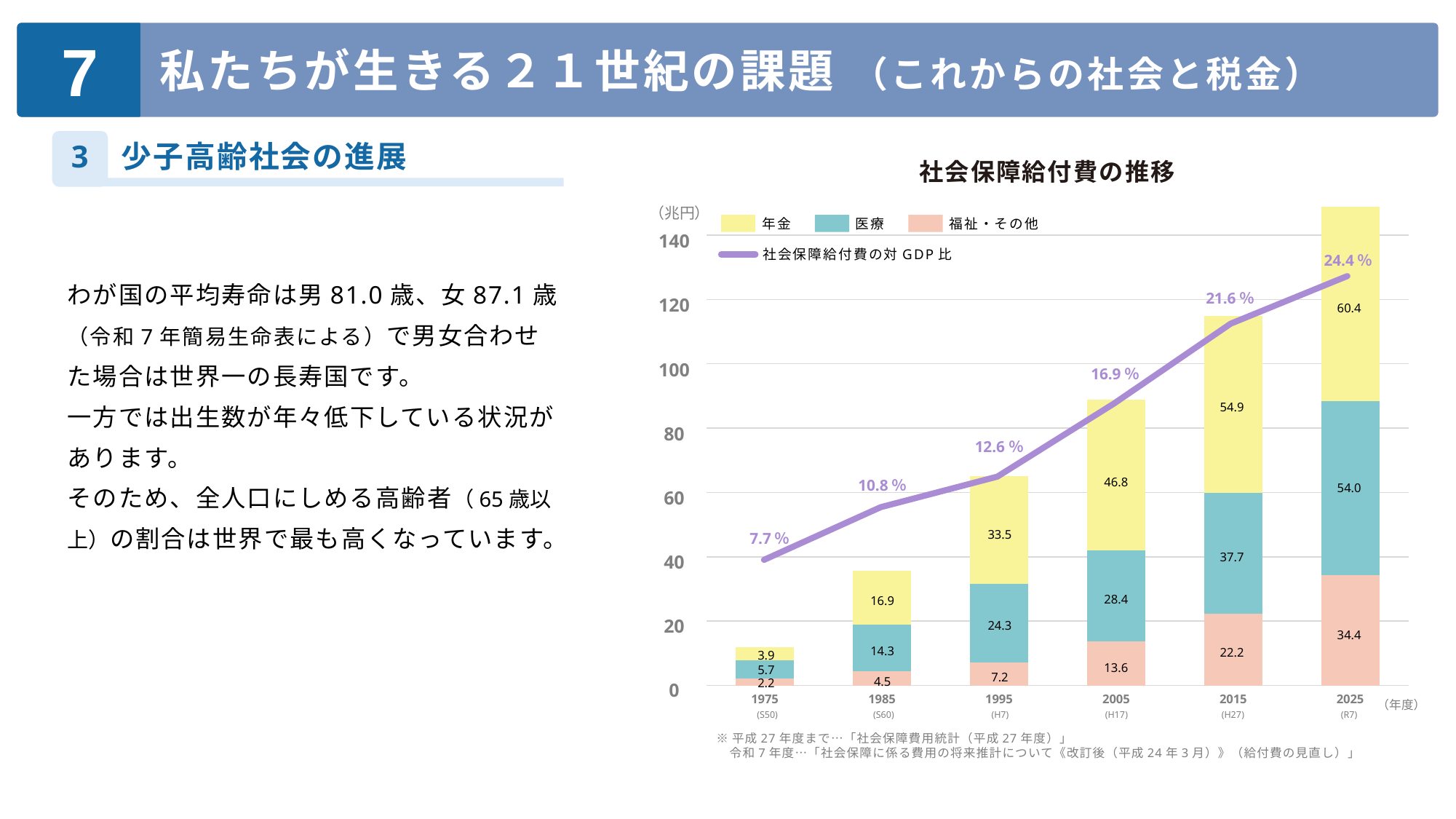
What is the total of the stacked bar for 2025? 148.8 What is the 医療 value for 1995 in the 社会保障給付費の推移 chart? 24.3 What is the difference between the 年金 values for 2015 and 2005? 8.1 Which year has the lowest 年金 value? 1975 Does the 社会保障給付費の対GDP比 line rise or fall from 1975 to 2025? rise What is the 福祉・その他 value for 1975? 2.2 How many series does the legend of the 社会保障給付費の推移 chart list? 4 Which year has the highest 医療 value? 2025 How many years are shown on the x axis of the 社会保障給付費の推移 chart? 6 What is the 社会保障給付費の対GDP比 value for 2005? 16.9% Which is larger, the 医療 value for 2015 or the 福祉・その他 value for 2025? 医療 for 2015 What is the 年金 value for 2025 in the 社会保障給付費の推移 chart? 60.4